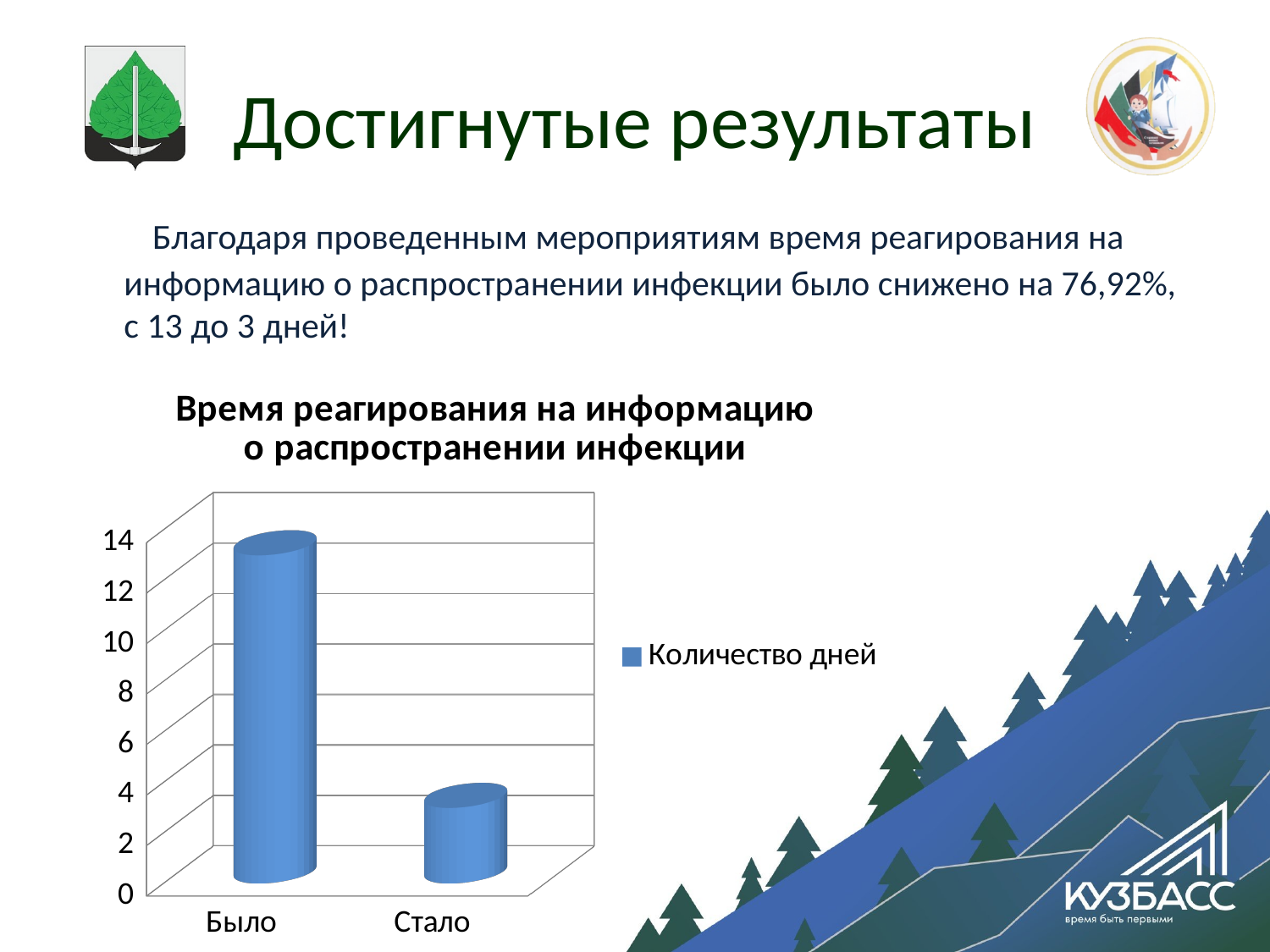
What is the title of the chart? Время реагирования на информацию о распространении инфекции Is the value for Было greater or less than 12? greater What series name is shown in the chart legend? Количество дней How many categories are shown on the x axis of the chart? 2 Which category has the lowest value in the chart? Стало How many series does the chart legend list? 1 Which is larger, the value for Было or the value for Стало? Было Do the values rise or fall from Было to Стало along the x axis? fall What kind of chart is shown on the slide? bar chart Which category has the highest value in the chart? Было According to the slide, how many days was the response time before (Было)? 13 Is the value for Стало greater or less than 4? less